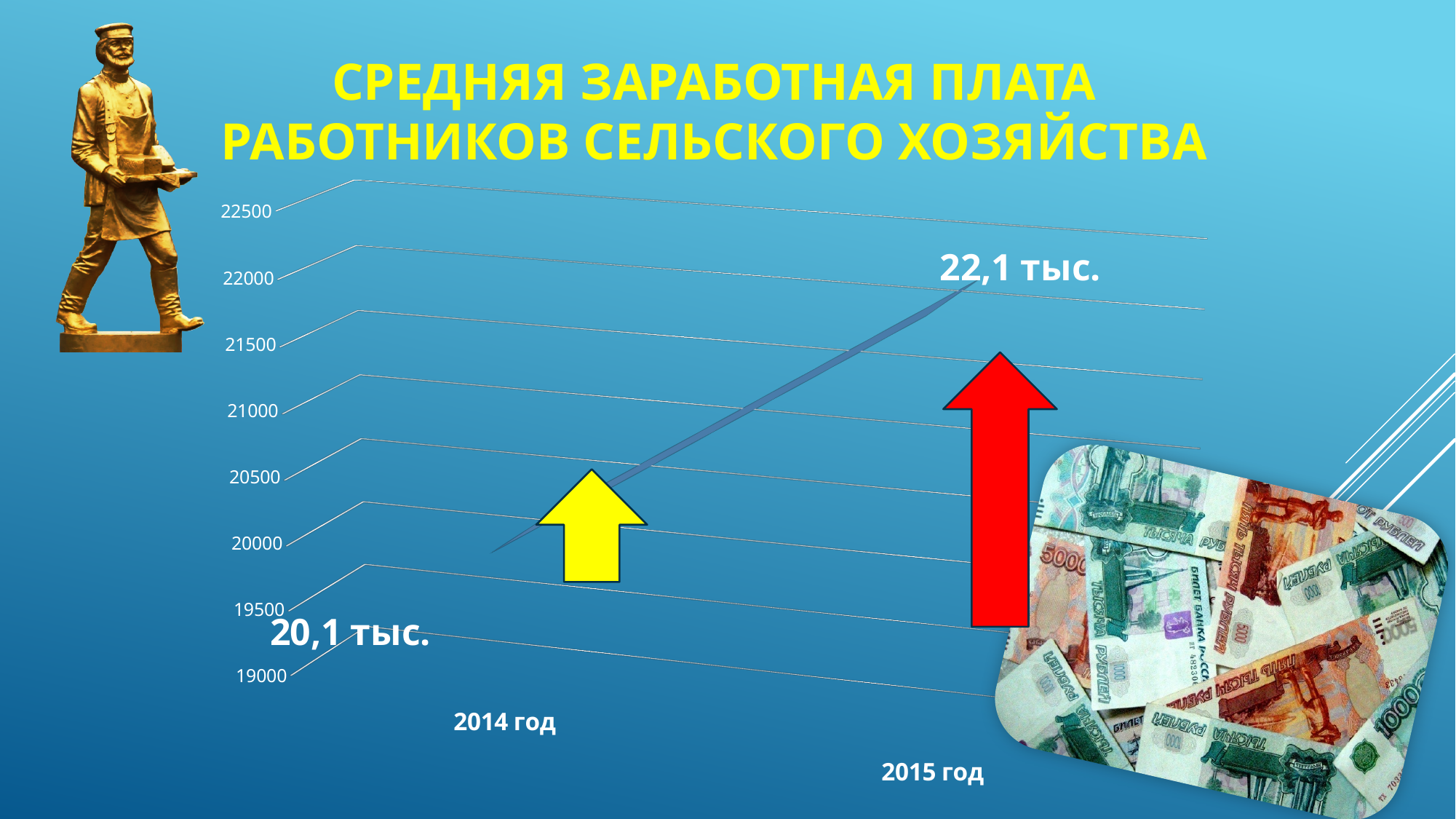
Is the value for 2015 год greater or less than 21500? greater What kind of chart is shown on the slide? Line chart By how much did the average salary increase from 2014 год to 2015 год? 2,0 тыс. Which year has the higher average salary on the chart? 2015 год Which year has the lower average salary on the chart? 2014 год What is the average salary value shown for 2014 год? 20,1 тыс. Is the value for 2015 год larger than the value for 2014 год? Yes How many years (data points) are plotted on the chart? 2 What is the average salary value shown for 2015 год? 22,1 тыс. Do the values rise or fall from 2014 год to 2015 год? Rise What is the title of the chart on the slide? Средняя заработная плата работников сельского хозяйства Is the value for 2014 год greater or less than 20500? less